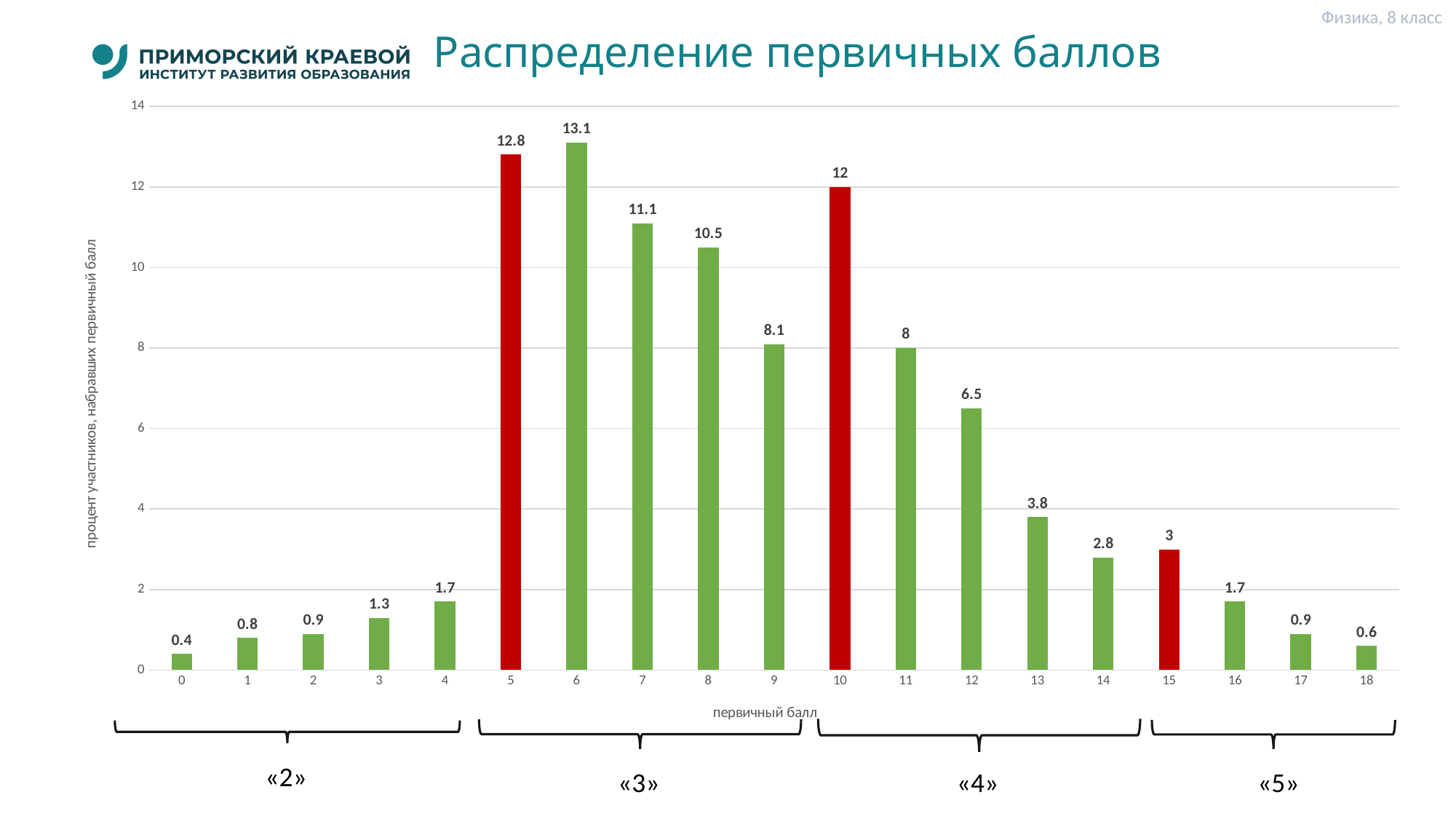
Which is larger, the value for primary score 7 or for primary score 8? 7 What is the difference between the values for primary scores 5 and 6? 0.3 What is the value shown for primary score 10? 12 Which primary score has the highest percentage of participants? 6 What percentage of participants scored a primary score of 6? 13.1 What is the difference between the values for primary scores 11 and 12? 1.5 Do the values rise or fall from primary score 10 to primary score 14? fall What type of chart is shown on the slide? bar chart What is the value shown for primary score 15? 3 Which primary score has the lowest percentage of participants? 0 How many primary score categories are shown on the x axis? 19 What is the title of the chart? Распределение первичных баллов